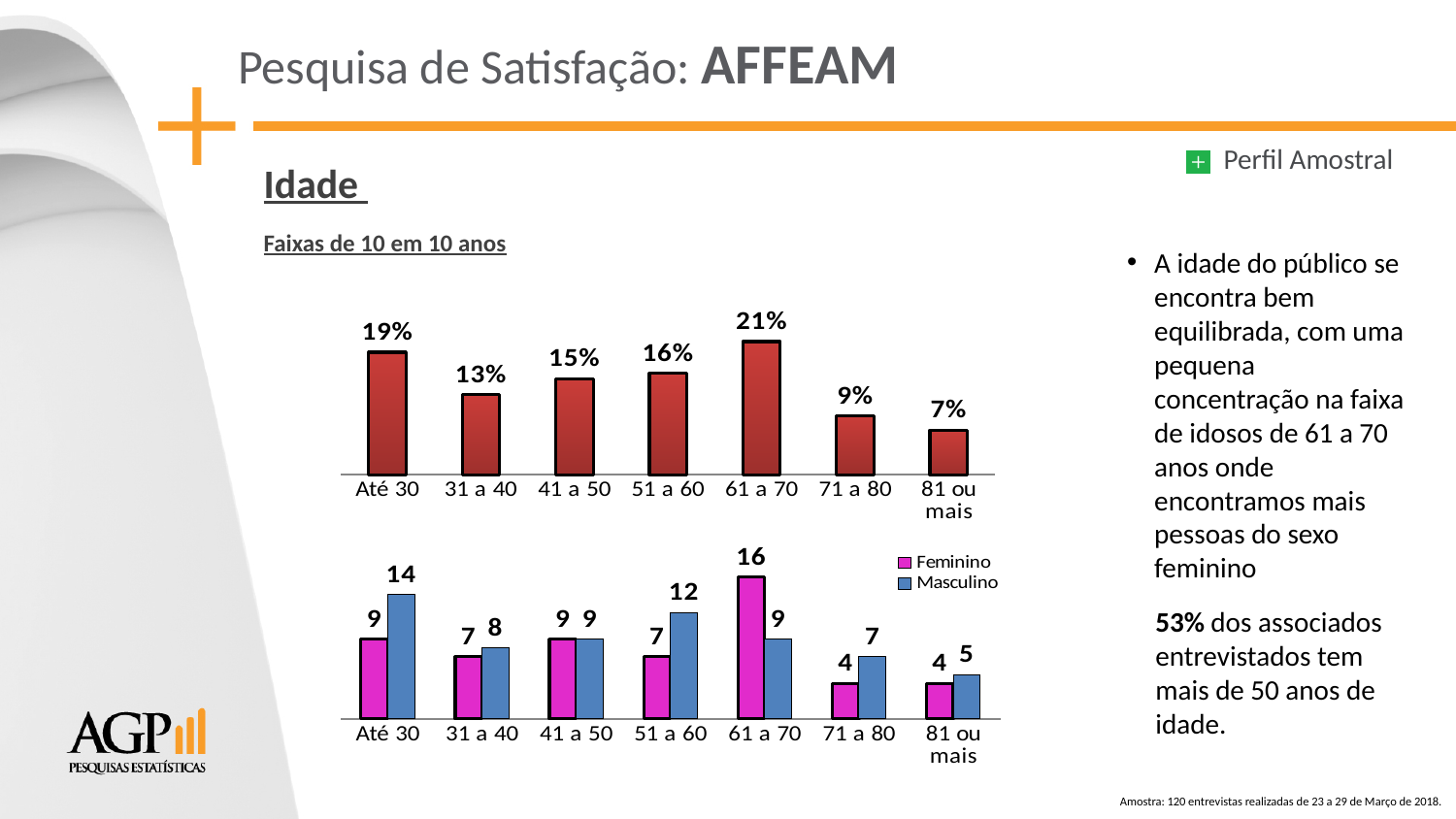
In the bottom chart, how many series does the legend list? 2 In the top chart, how many age bands are shown on the x axis? 7 In the top chart, what is the value for the 61 a 70 age band? 21% In the bottom chart, what is the Masculino value for the Até 30 age band? 14 In the bottom chart, which colour represents the Feminino series? Magenta (pink) What kind of chart is the bottom chart? Bar chart In the bottom chart, what is the difference between the Masculino and Feminino values for the 61 a 70 age band? 7 In the top chart, what is the difference between the values for Até 30 and 31 a 40? 6% In the top chart, which age band has the lowest value? 81 ou mais In the bottom chart, what is the Feminino value for the 61 a 70 age band? 16 In the bottom chart, which is larger for the 51 a 60 age band, Feminino or Masculino? Masculino In the top chart, which age band has the highest value? 61 a 70